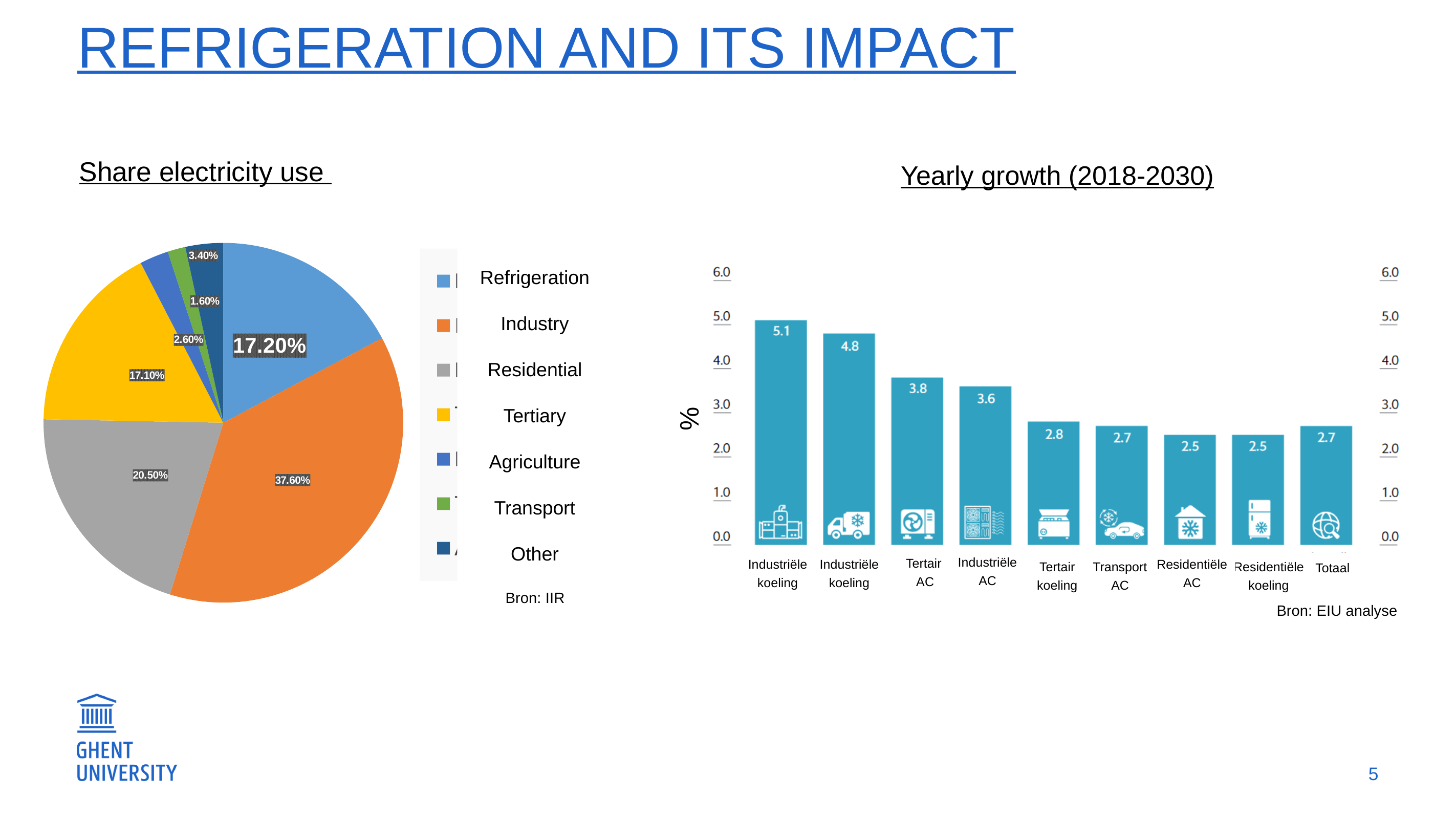
In the 'Share electricity use' pie chart, which category has the largest share? Industry What kind of chart is the 'Share electricity use' chart? Pie chart In the 'Share electricity use' pie chart, what is the difference between the Residential and Tertiary shares? 3.40% In the 'Yearly growth (2018-2030)' chart, what is the value for Tertair AC? 3.8 In the 'Share electricity use' pie chart, how many categories does the legend list? 7 In the 'Share electricity use' pie chart, what share does Industry have? 37.60% In the 'Share electricity use' pie chart, which category has the smallest share? Transport In the 'Yearly growth (2018-2030)' chart, what is the value for Totaal? 2.7 In the 'Share electricity use' pie chart, what share does Refrigeration have? 17.20% In the 'Yearly growth (2018-2030)' chart, how many bars are plotted? 9 In the 'Yearly growth (2018-2030)' chart, which of Industriële AC and Tertair koeling has the larger value? Industriële AC What kind of chart is the 'Yearly growth (2018-2030)' chart? Bar chart